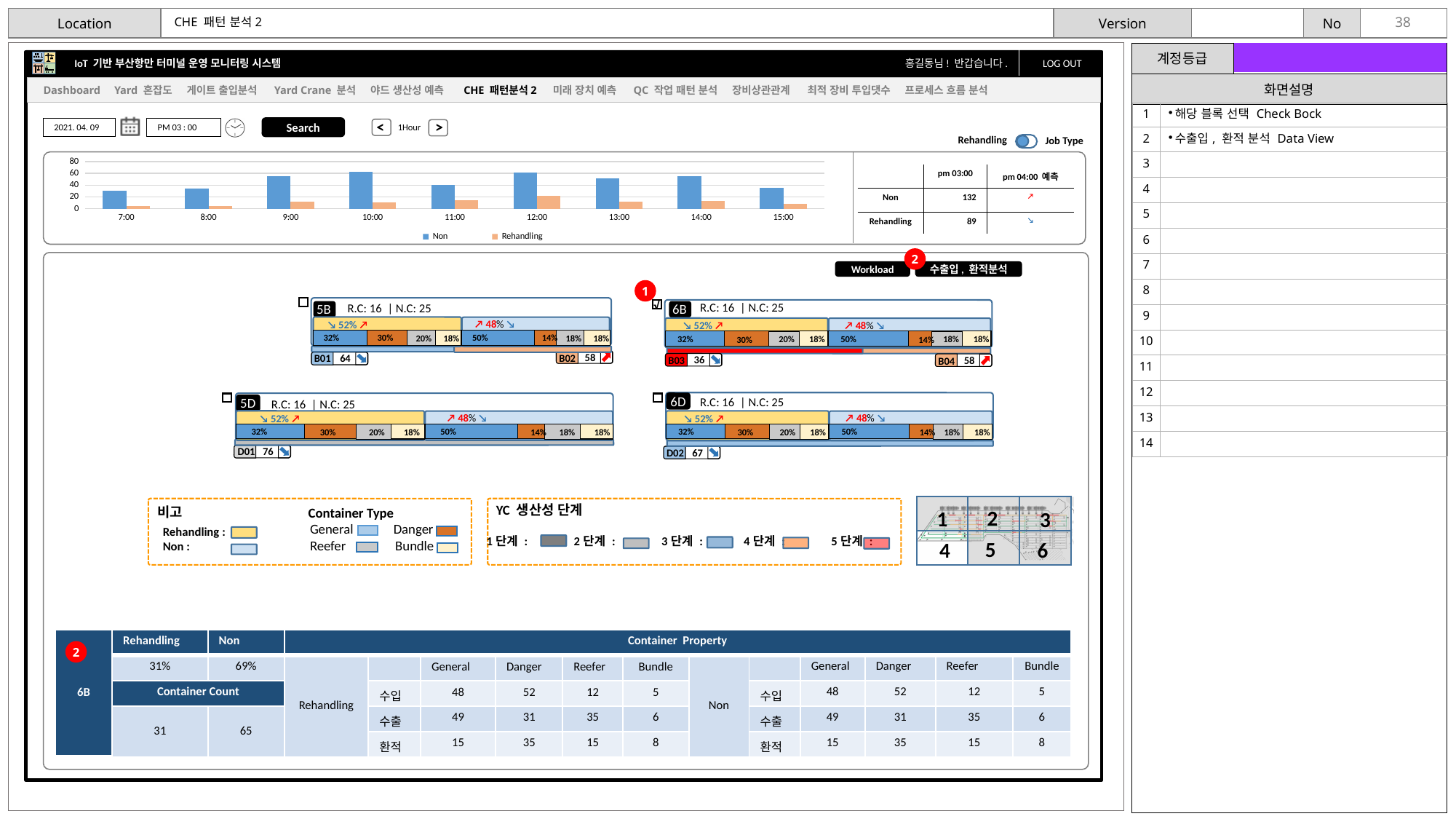
What kind of chart is shown at the top of the monitoring screen (the hourly Non / Rehandling chart)? bar chart How many time points are shown on the x axis of the hourly bar chart? 9 In the hourly bar chart, is the Non value at 7:00 greater or less than 40? less In the hourly bar chart, which is larger at 12:00: the Non value or the Rehandling value? Non In the hourly bar chart, is the Rehandling value at 12:00 greater or less than 40? less In the hourly bar chart, do the Non values rise or fall from 7:00 to 10:00? rise How many series does the legend of the hourly bar chart list? 2 In the hourly bar chart, at which time is the Rehandling value highest? 12:00 In the hourly bar chart, is the Non value at 10:00 greater or less than 40? greater In the hourly bar chart, which is larger: the Non value at 10:00 or the Non value at 7:00? 10:00 What are the two series named in the legend of the hourly bar chart? Non and Rehandling